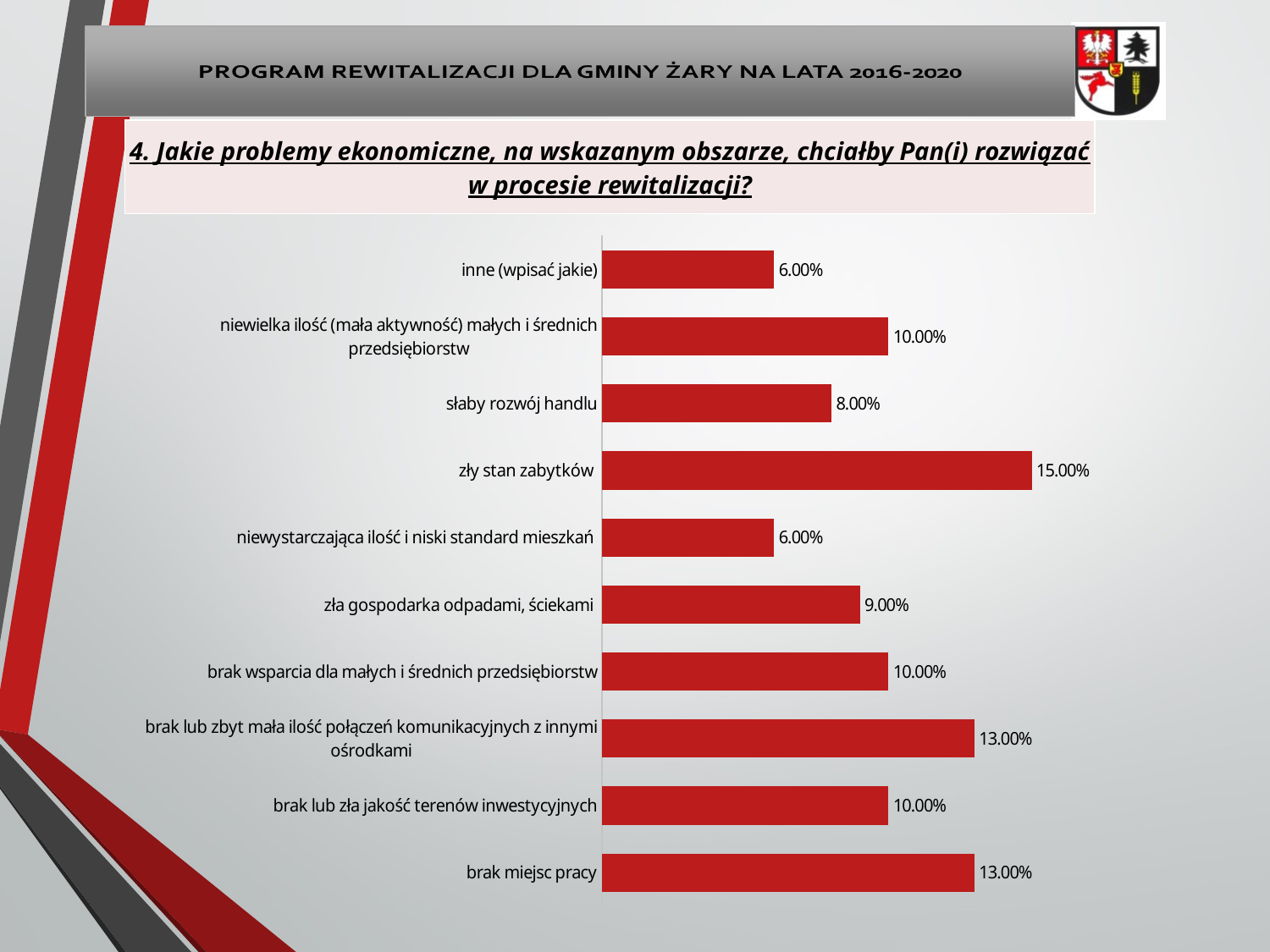
What is the value for "zły stan zabytków"? 15.00% How many categories are shown in the chart? 10 What kind of chart is shown on the slide? bar chart What is the value for "słaby rozwój handlu"? 8.00% What colour are the bars in the chart? red Which category has the highest value? zły stan zabytków What is the difference between the values for "brak miejsc pracy" and "brak lub zła jakość terenów inwestycyjnych"? 3.00% What is the difference between the values for "zły stan zabytków" and "inne (wpisać jakie)"? 9.00% What is the value for "brak lub zbyt mała ilość połączeń komunikacyjnych z innymi ośrodkami"? 13.00% What is the value for "brak miejsc pracy"? 13.00% Which is larger: the value for "słaby rozwój handlu" or the value for "zła gospodarka odpadami, ściekami"? zła gospodarka odpadami, ściekami What is the value for "zła gospodarka odpadami, ściekami"? 9.00%